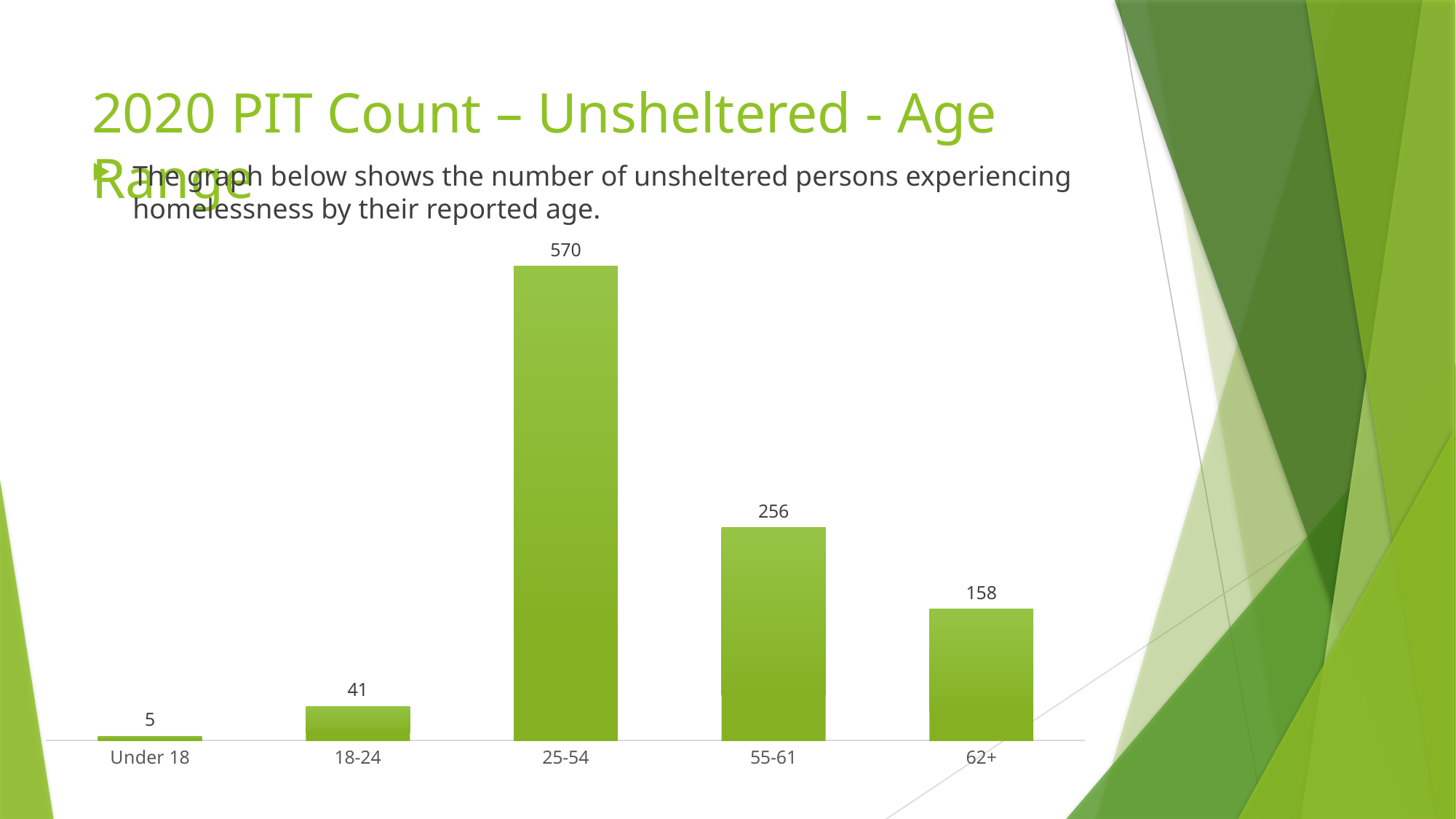
What kind of chart is shown on the slide? Bar chart What is the difference between the values for 55-61 and 62+? 98 Which age range has the lowest value? Under 18 Which is larger, the value for 18-24 or the value for 62+? 62+ What is the value for the 18-24 age range? 41 Which age range has the highest value? 25-54 What is the value for the 25-54 age range? 570 How many age range categories are shown in the chart? 5 What is the difference between the values for 25-54 and 55-61? 314 What colour are the bars in the chart? Green What is the value for the Under 18 age range? 5 What is the value for the 62+ age range? 158